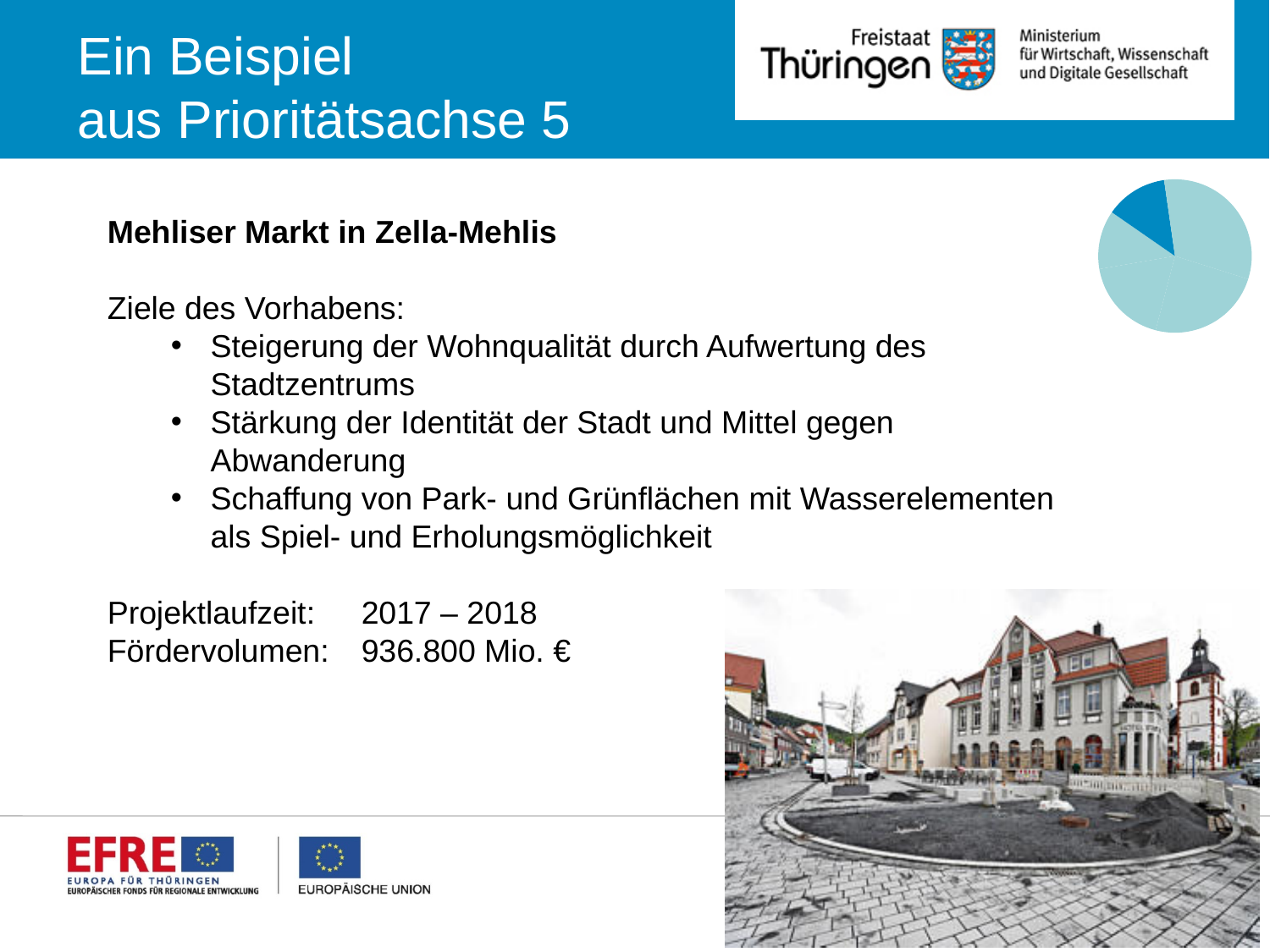
In the pie chart in the top right corner, is the dark blue slice greater or less than half of the pie? less Does the pie chart in the top right corner have a legend? No What kind of chart is shown in the top right corner of the slide? pie chart In the pie chart in the top right corner, which slice is larger, the dark blue one or the light blue one? the light blue one